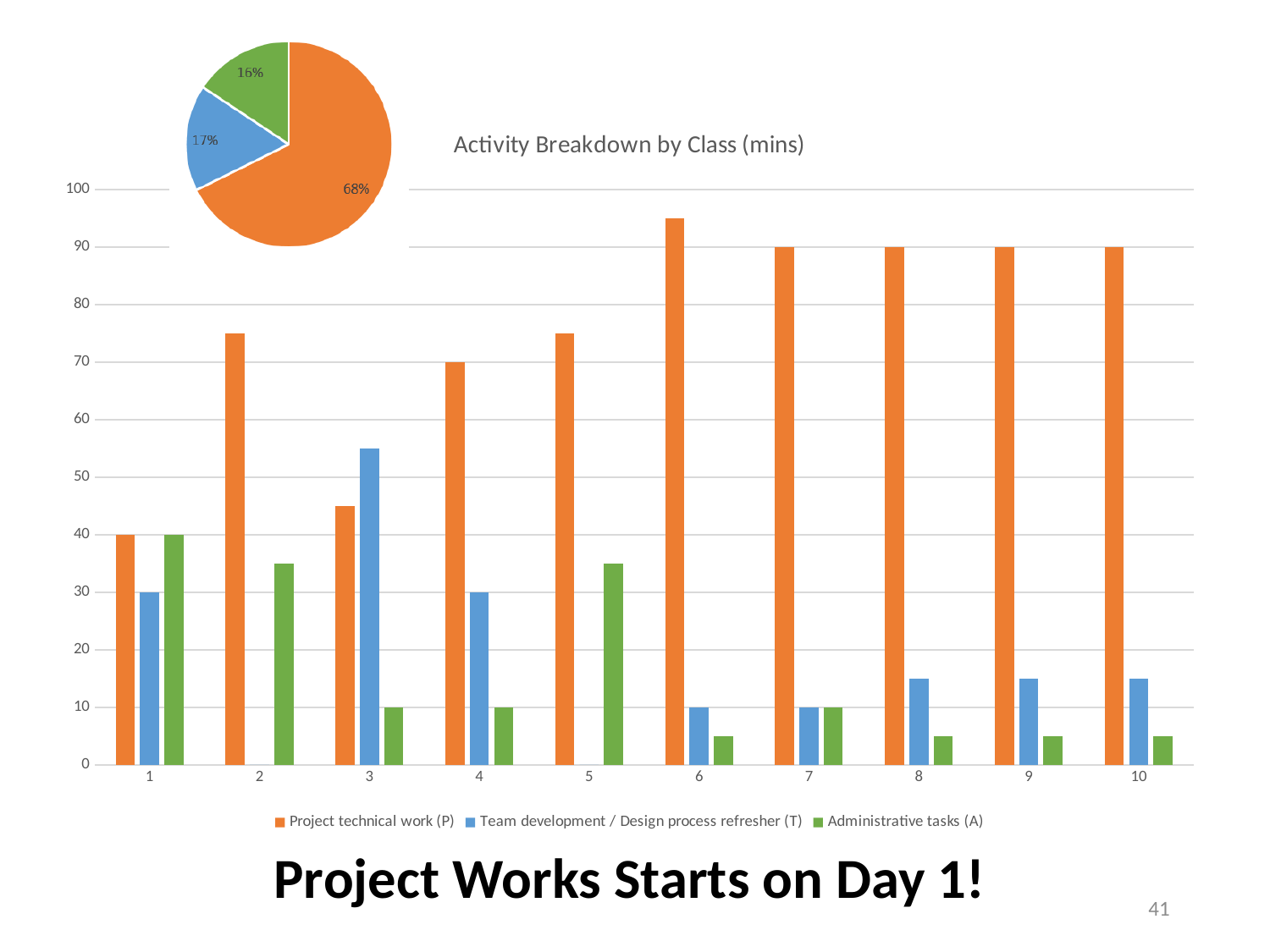
In the 'Activity Breakdown by Class (mins)' chart, is the Project technical work (P) value for class 2 greater or less than 70? greater In the 'Activity Breakdown by Class (mins)' chart, which class has the highest Project technical work (P) value? 6 In the 'Activity Breakdown by Class (mins)' chart, what is the value of Team development / Design process refresher (T) for class 1? 30 In the 'Activity Breakdown by Class (mins)' chart, what is the value of Project technical work (P) for class 4? 70 In the 'Activity Breakdown by Class (mins)' chart, how many classes are shown on the x axis? 10 What kind of chart is the large chart titled 'Activity Breakdown by Class (mins)'? bar chart In the 'Activity Breakdown by Class (mins)' chart, for class 3, which is larger: Project technical work (P) or Team development / Design process refresher (T)? Team development / Design process refresher (T) In the 'Activity Breakdown by Class (mins)' chart, which class has the highest Team development / Design process refresher (T) value? 3 In the pie chart at the top left, what percentage does the largest (orange) slice show? 68% In the pie chart at the top left, what percentage does the green slice show? 16% In the 'Activity Breakdown by Class (mins)' chart, how many series does the legend list? 3 In the 'Activity Breakdown by Class (mins)' chart, what is the value of Administrative tasks (A) for class 1? 40